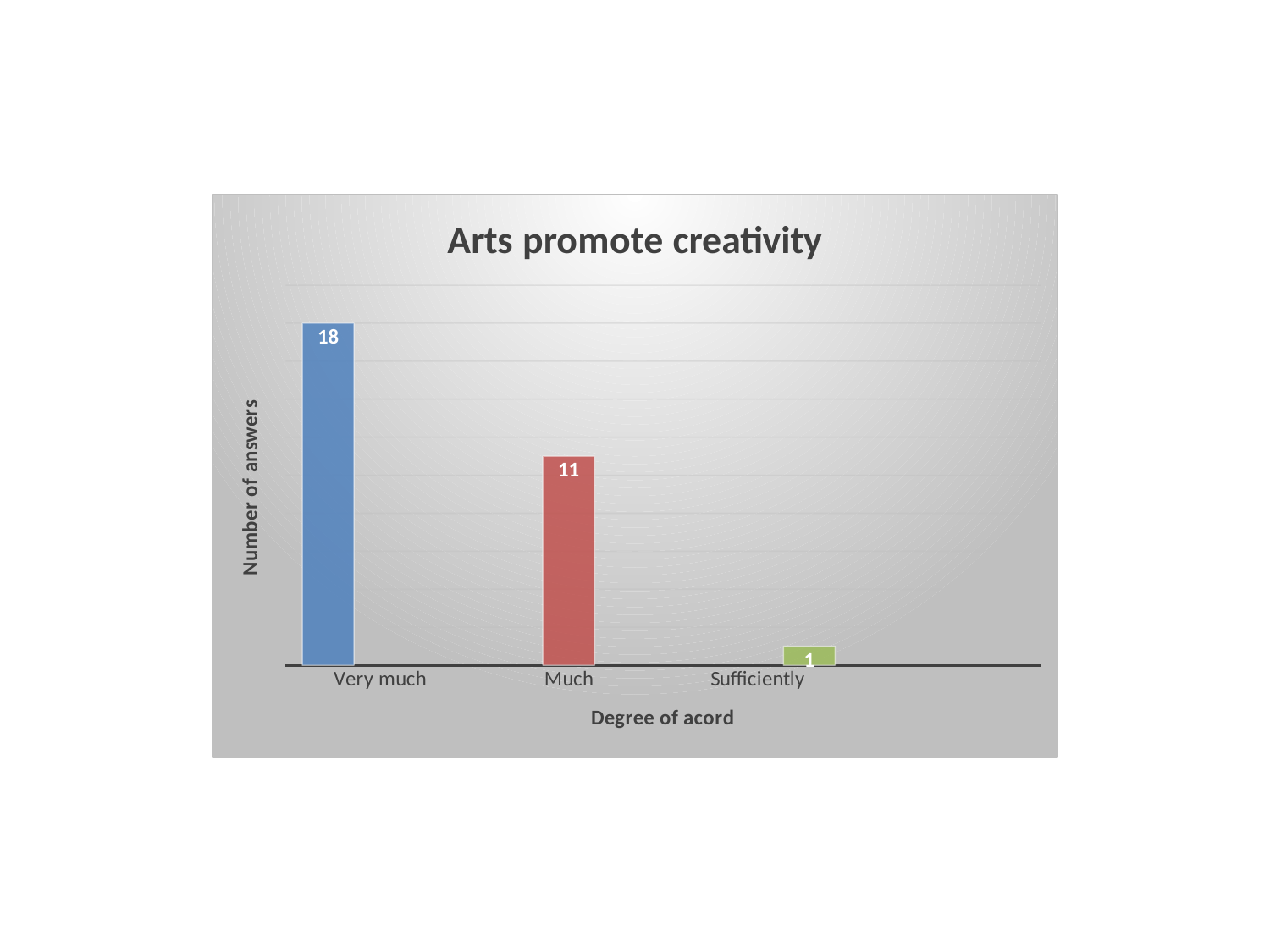
How many categories are shown on the x axis? 3 What is the difference in number of answers between "Much" and "Sufficiently"? 10 What kind of chart is shown on the slide? Bar chart What is the number of answers for "Sufficiently"? 1 What is the number of answers for "Very much"? 18 Do the values rise or fall from left to right along the x axis? Fall Which category has the lowest number of answers? Sufficiently Which category has the highest number of answers? Very much What is the number of answers for "Much"? 11 What is the difference in number of answers between "Very much" and "Much"? 7 Which has more answers, "Much" or "Sufficiently"? Much What is the title of the chart? Arts promote creativity